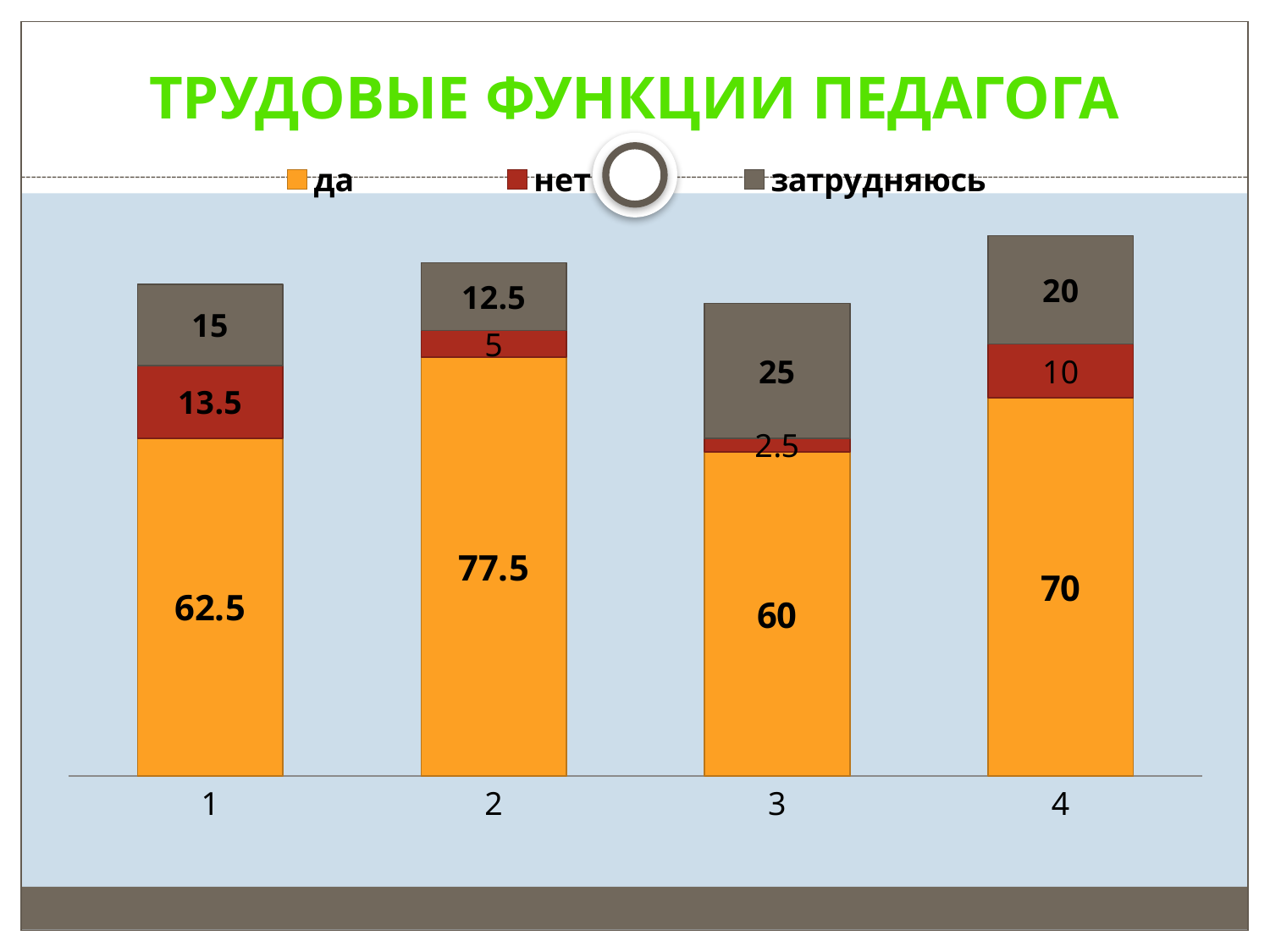
What is the difference between the "да" values for category 2 and category 3? 17.5 Which is larger: the "затрудняюсь" value for category 3 or for category 4? category 3 Which category has the lowest value for "нет"? 3 What is the total of the stacked bar for category 4? 100 How many categories are shown on the x axis? 4 What kind of chart is shown on the slide? stacked bar chart Which category has the highest value for "да"? 2 What is the value of "да" for category 2? 77.5 What is the value of "нет" for category 1? 13.5 How many series does the legend list? 3 What is the value of "нет" for category 4? 10 What is the value of "затрудняюсь" for category 3? 25